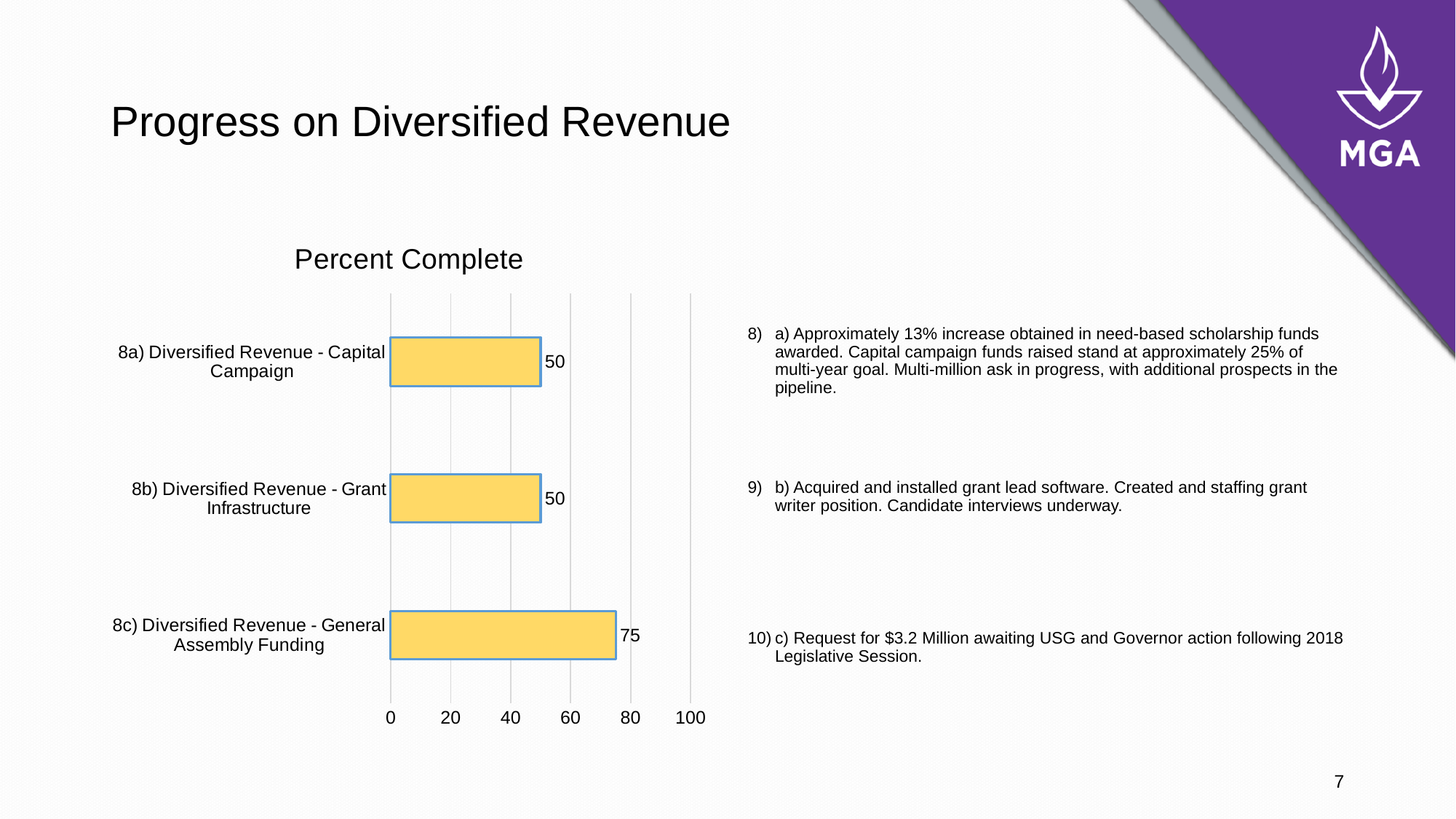
Is the value for 8c) Diversified Revenue - General Assembly Funding greater or less than 60? greater What is the maximum value shown on the chart's axis? 100 What is the percent complete value for 8b) Diversified Revenue - Grant Infrastructure? 50 What kind of chart is shown on the slide? Bar chart Which category has the highest percent complete? 8c) Diversified Revenue - General Assembly Funding What is the percent complete value for 8c) Diversified Revenue - General Assembly Funding? 75 What is the percent complete value for 8a) Diversified Revenue - Capital Campaign? 50 What is the difference between the percent complete for 8c) General Assembly Funding and 8a) Capital Campaign? 25 What is the title of the chart? Percent Complete Is the value for 8a) Diversified Revenue - Capital Campaign greater or less than 80? less How many categories are shown in the chart? 3 Which is larger, the value for 8c) General Assembly Funding or the value for 8b) Grant Infrastructure? 8c) Diversified Revenue - General Assembly Funding